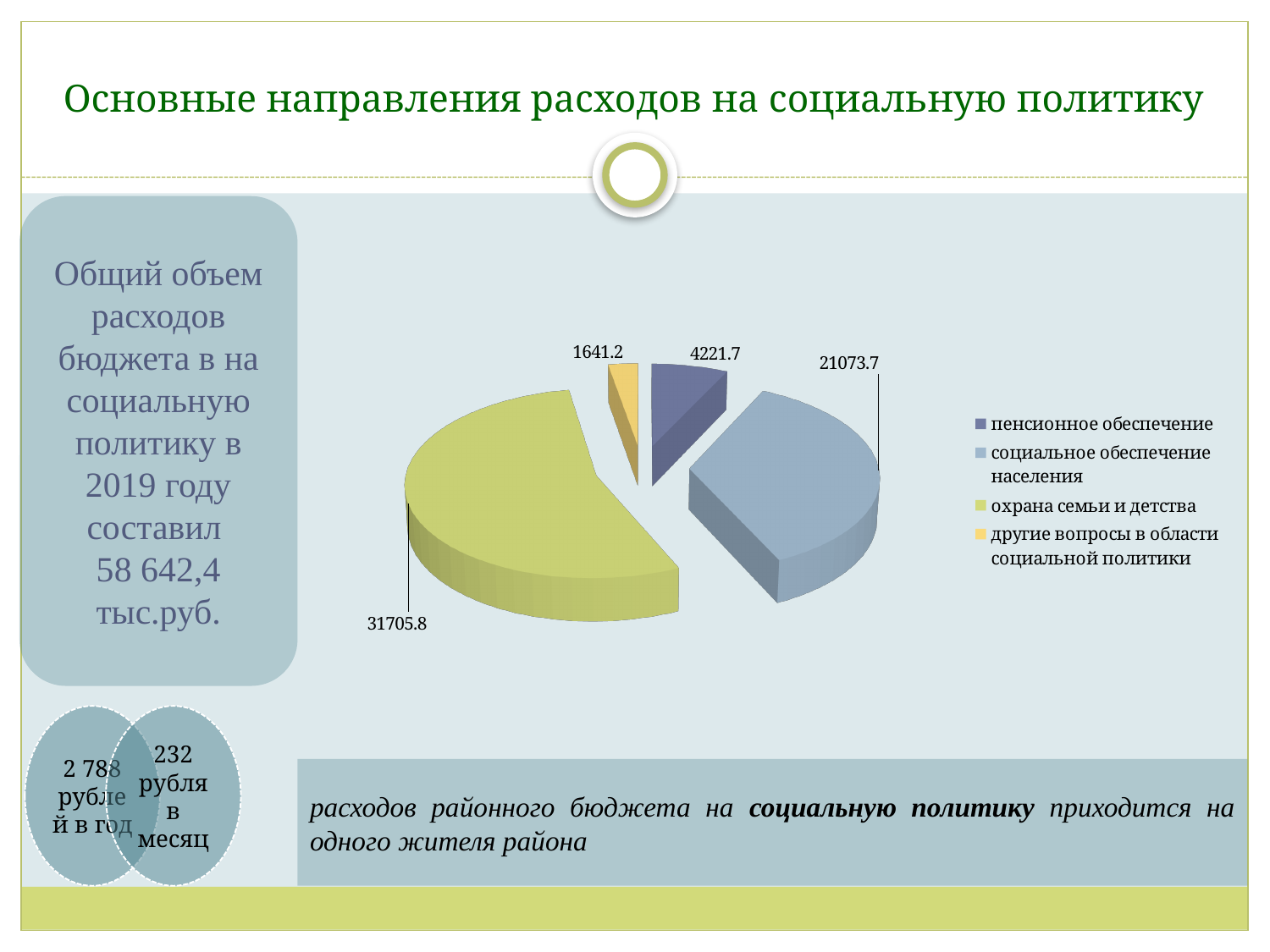
How many slices does the pie chart have? 4 What is the value for другие вопросы в области социальной политики? 1641.2 Which category has the smallest slice of the pie? другие вопросы в области социальной политики What colour is the slice for охрана семьи и детства? green What is the value for социальное обеспечение населения? 21073.7 What kind of chart is shown on the slide? pie chart What is the difference between the values for пенсионное обеспечение and другие вопросы в области социальной политики? 2580.5 What is the difference between the values for охрана семьи и детства and социальное обеспечение населения? 10632.1 Which is larger: социальное обеспечение населения or пенсионное обеспечение? социальное обеспечение населения Which category has the largest slice of the pie? охрана семьи и детства What is the value for охрана семьи и детства? 31705.8 What is the value for пенсионное обеспечение? 4221.7